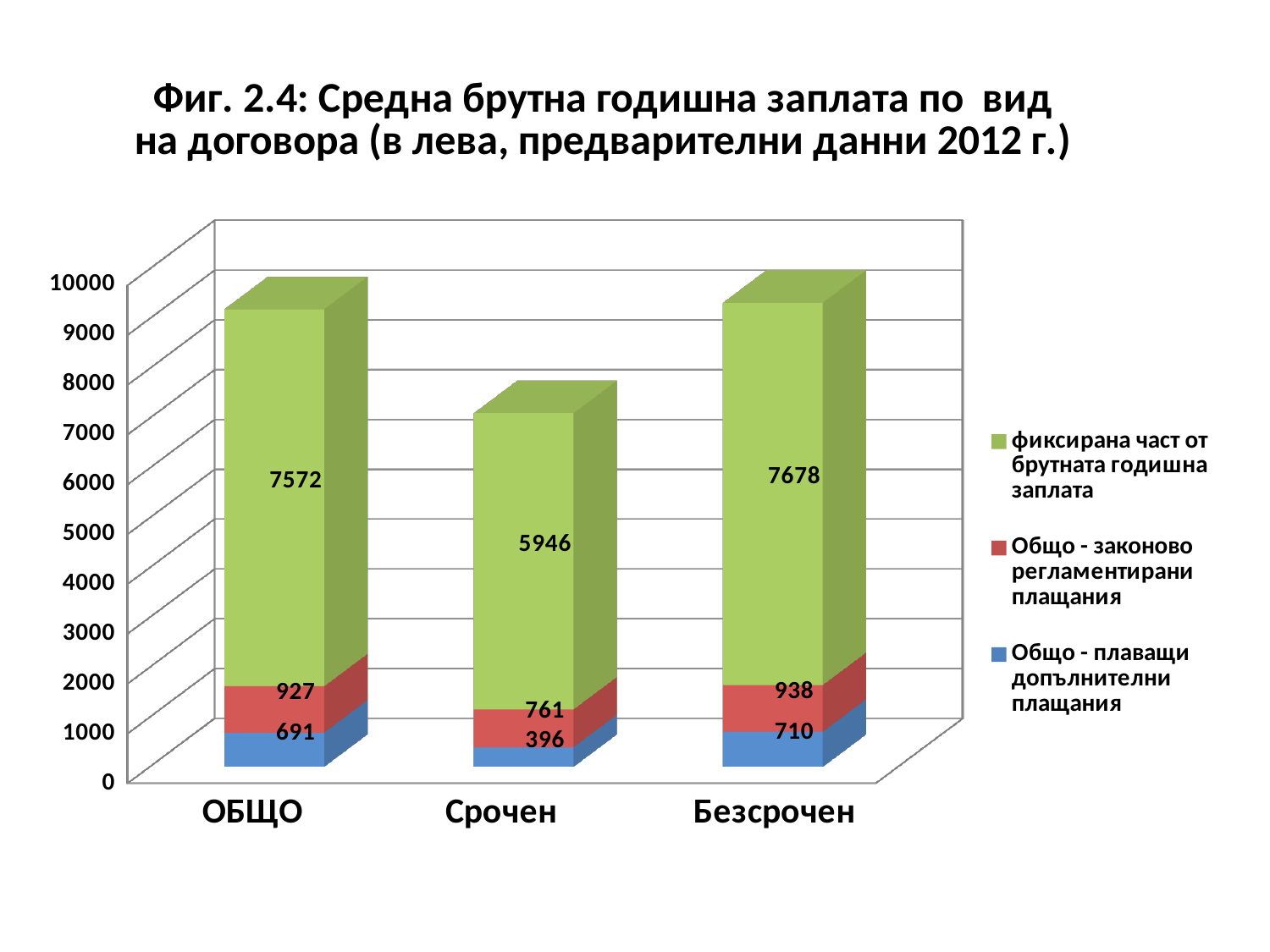
How many categories are shown on the x axis? 3 What kind of chart is shown on the slide? Stacked bar chart What is the value of the fixed part of gross annual salary (фиксирана част от брутната годишна заплата) for Срочен? 5946 What is the value of Общо - законово регламентирани плащания for Безсрочен? 938 Which category has the lowest value for Общо - плаващи допълнителни плащания? Срочен How many series does the legend list? 3 What is the value of Общо - плаващи допълнителни плащания for ОБЩО? 691 What is the total of the stacked bar for ОБЩО? 9190 What is the difference between the fixed part of gross annual salary for Безсрочен and for Срочен? 1732 Which is larger: Общо - законово регламентирани плащания for ОБЩО or for Безсрочен? Безсрочен What is the total of the stacked bar for Срочен? 7103 Which contract type has the highest value for the fixed part of gross annual salary? Безсрочен